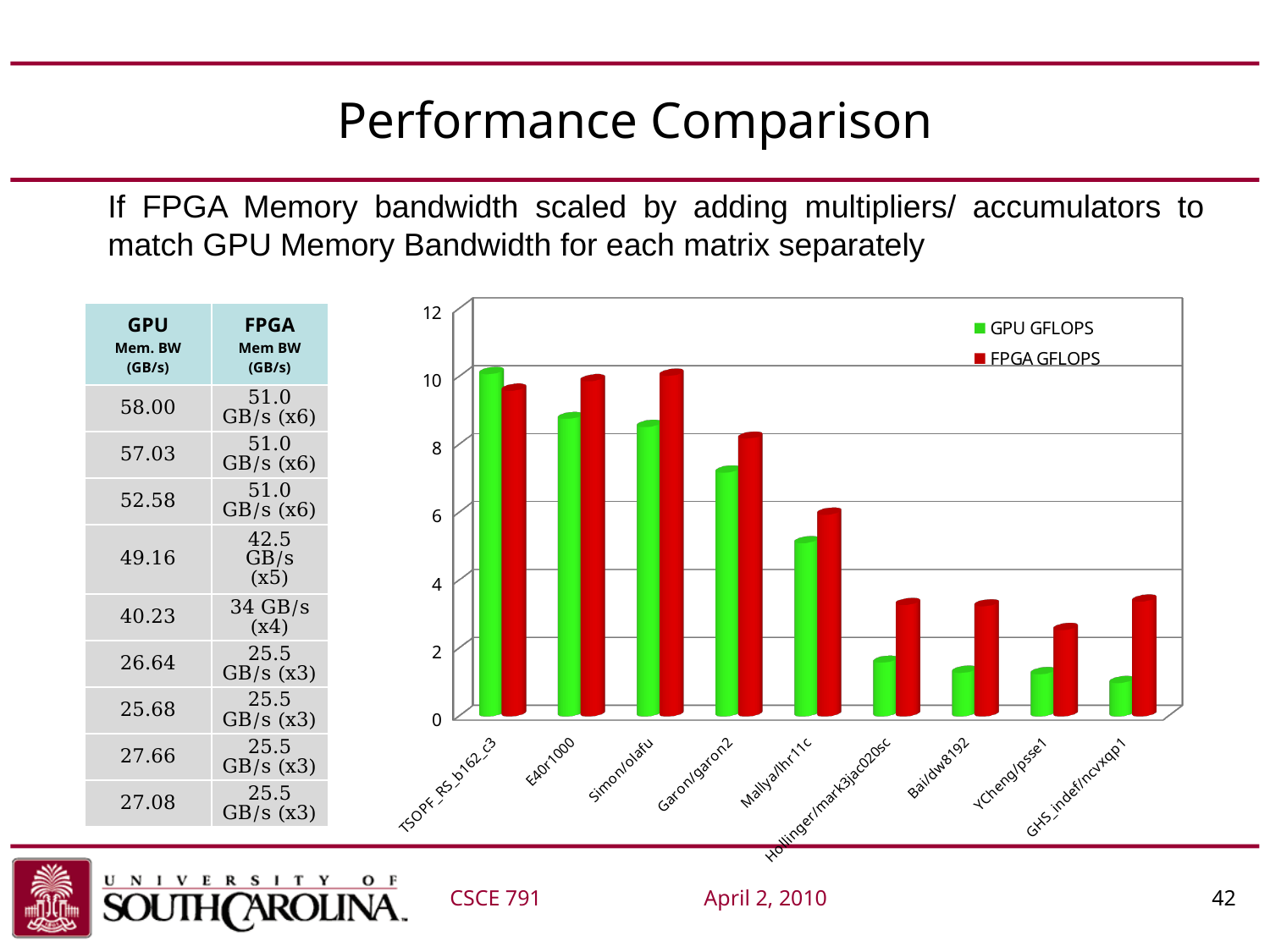
Is the FPGA GFLOPS value for Garon/garon2 greater or less than 6? greater How many matrices (categories) are shown on the x axis of the chart? 9 What kind of chart is shown on the slide? bar chart Is the GPU GFLOPS value for Hollinger/mark3jac020sc greater or less than 4? less Which matrix has the lowest FPGA GFLOPS value? YCheng/psse1 For Hollinger/mark3jac020sc, which is larger: GPU GFLOPS or FPGA GFLOPS? FPGA GFLOPS Is the FPGA GFLOPS value for GHS_indef/ncvxqp1 greater or less than 2? greater What colour are the FPGA GFLOPS bars in the chart? red How many series does the chart legend list? 2 Which matrix has the highest GPU GFLOPS value? TSOPF_RS_b162_c3 Do the GPU GFLOPS values rise or fall moving from left to right along the x axis? fall